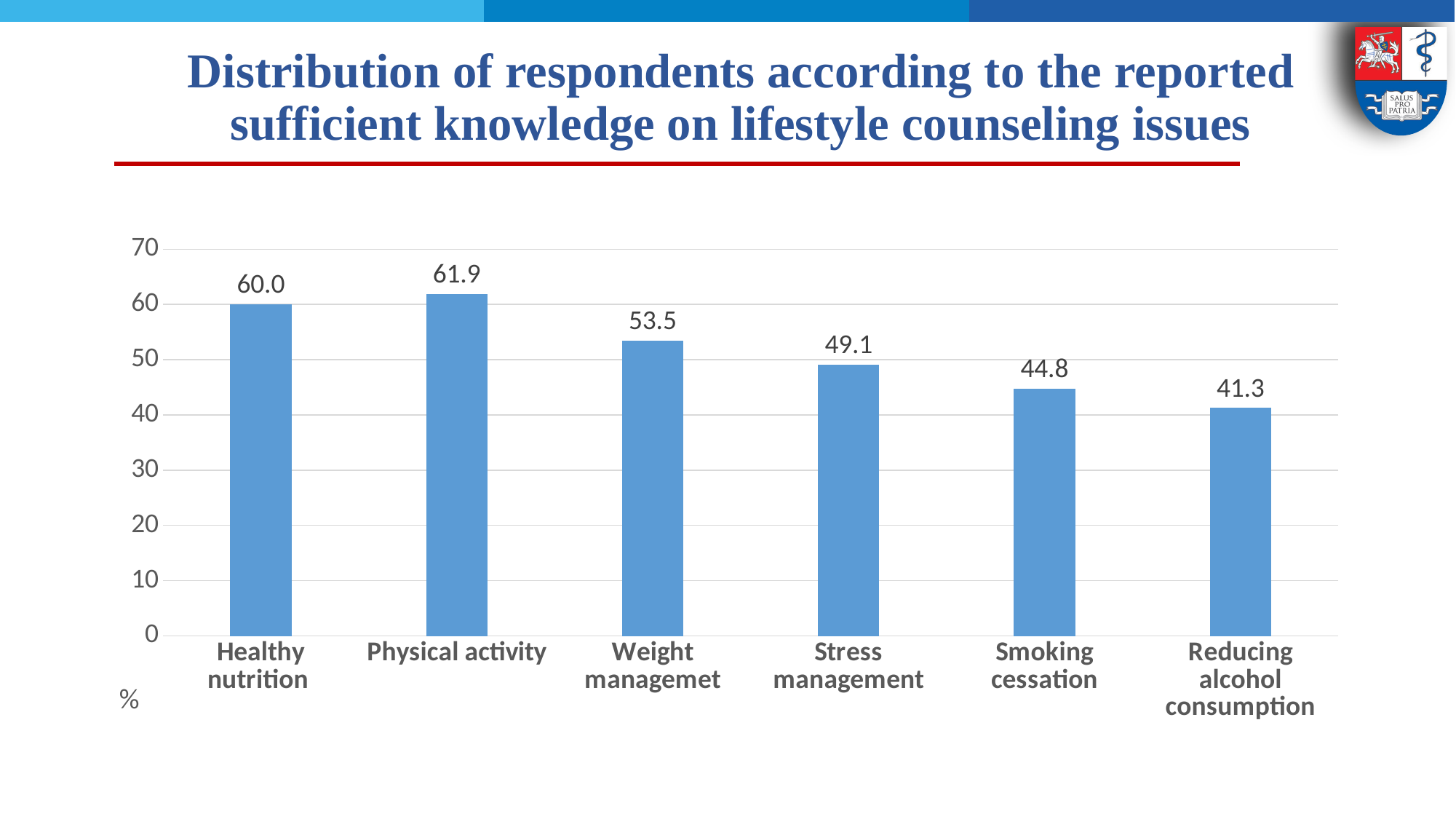
What is the value for Physical activity? 61.9 What is the value for Healthy nutrition? 60.0 How many categories are shown in the chart? 6 What unit is indicated on the vertical axis of the chart? % What is the difference between the values for Physical activity and Reducing alcohol consumption? 20.6 Which category has the lowest value? Reducing alcohol consumption Which category has the highest value? Physical activity What is the value for Reducing alcohol consumption? 41.3 What is the value for Stress management? 49.1 What is the value for Weight managemet? 53.5 Which is larger, the value for Stress management or the value for Smoking cessation? Stress management What kind of chart is shown on the slide? Bar chart